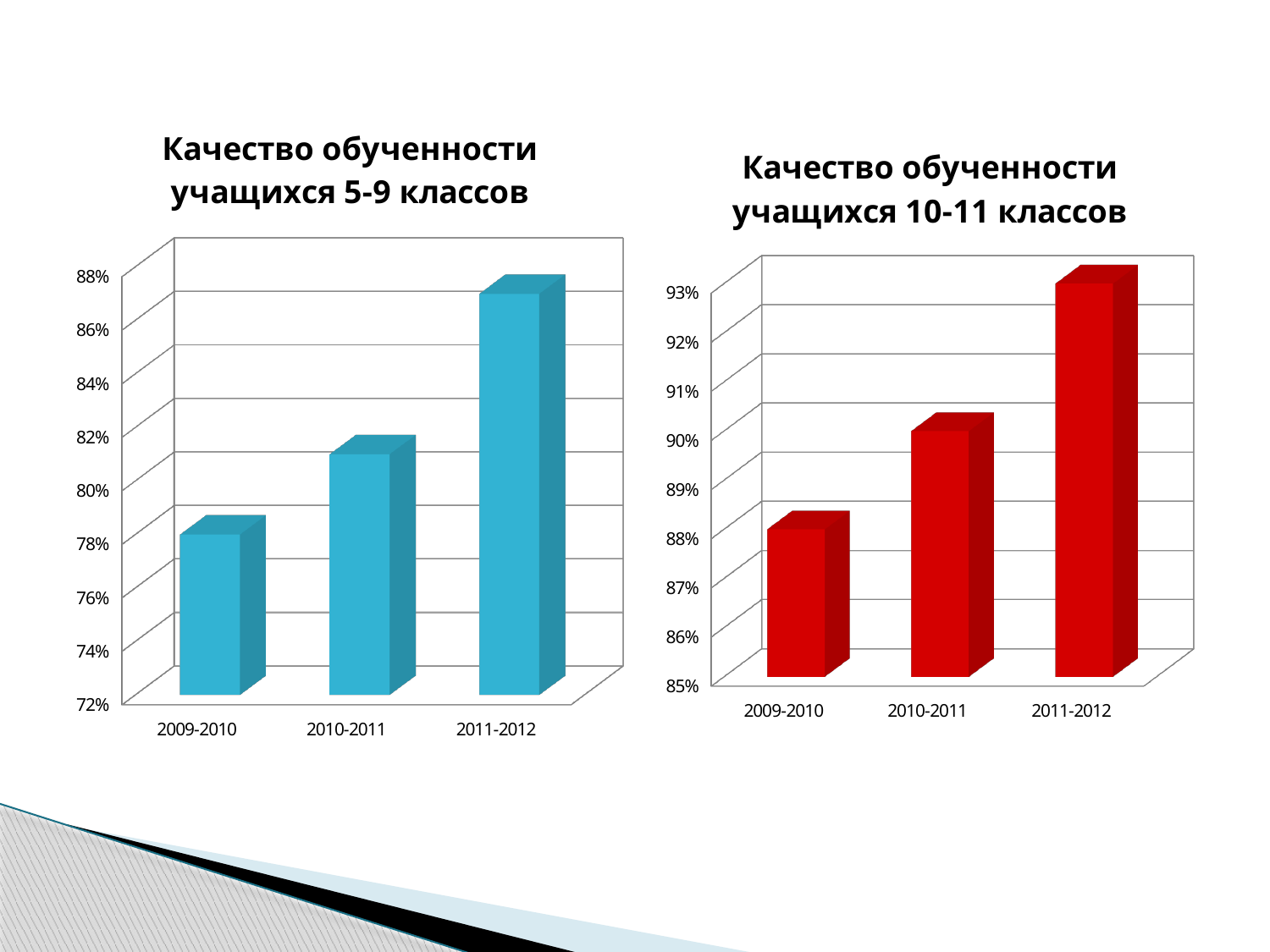
What kind of chart is the left chart, 'Качество обученности учащихся 5-9 классов'? bar chart What colour are the bars in the right chart, 'Качество обученности учащихся 10-11 классов'? red In the right chart, 'Качество обученности учащихся 10-11 классов', is the value for 2009-2010 greater or less than 90%? less In the right chart, 'Качество обученности учащихся 10-11 классов', which year has the highest value? 2011-2012 In the right chart, 'Качество обученности учащихся 10-11 классов', is the value for 2011-2012 greater or less than 92%? greater In the right chart, 'Качество обученности учащихся 10-11 классов', which is larger, the value for 2010-2011 or the value for 2009-2010? 2010-2011 How many categories are shown on the x axis of the left chart, 'Качество обученности учащихся 5-9 классов'? 3 In the left chart, 'Качество обученности учащихся 5-9 классов', which year has the lowest value? 2009-2010 In the left chart, 'Качество обученности учащихся 5-9 классов', is the value for 2011-2012 greater or less than 86%? greater In the left chart, 'Качество обученности учащихся 5-9 классов', which year has the highest value? 2011-2012 In the left chart, 'Качество обученности учащихся 5-9 классов', do the values rise or fall from 2009-2010 to 2011-2012? rise